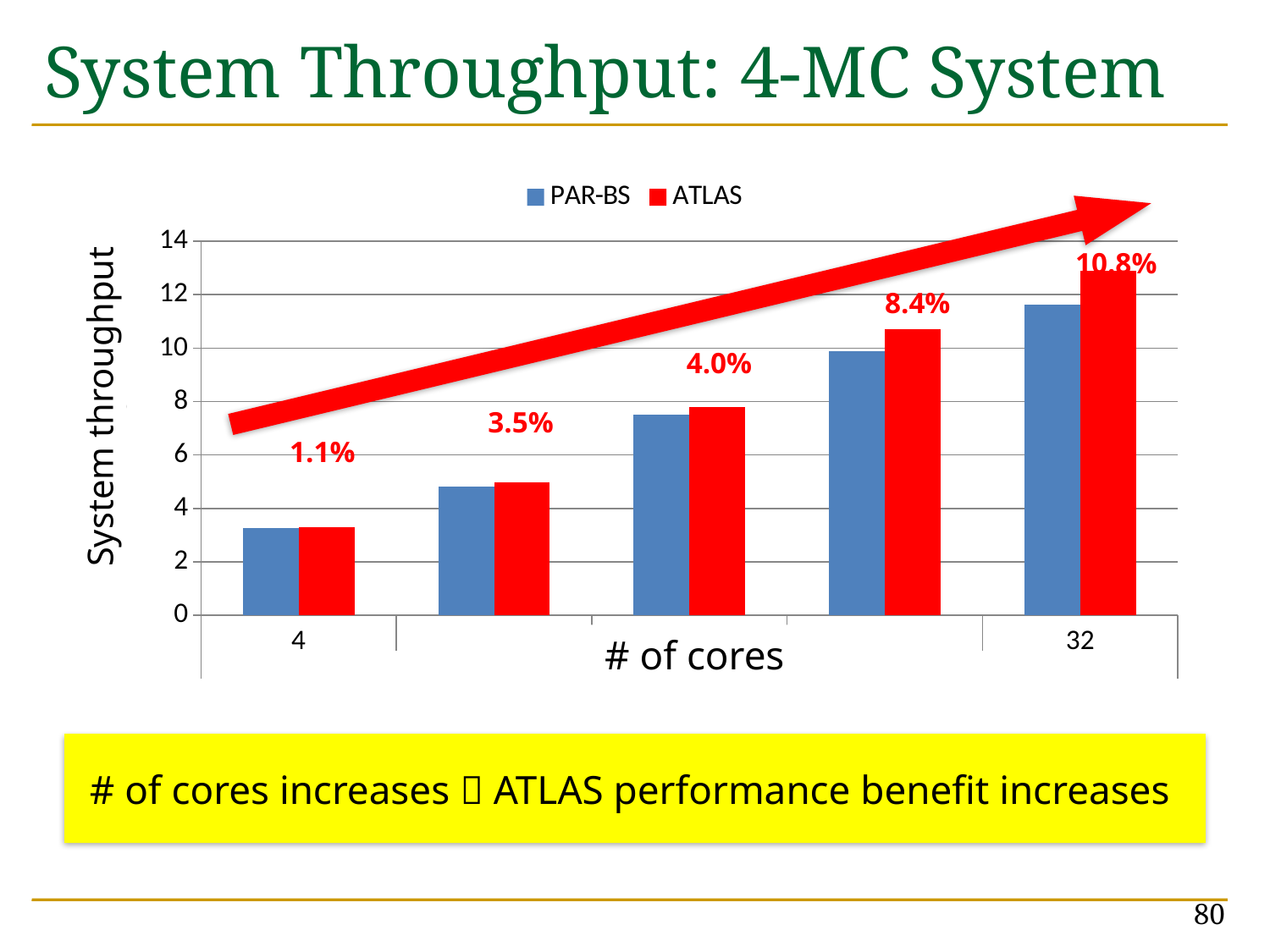
How many groups of bars are plotted along the x axis? 5 How many series does the legend list? 2 What is the label on the y axis? System throughput Is the ATLAS value for 32 cores greater or less than 12? greater What are the two series named in the legend? PAR-BS and ATLAS Is the PAR-BS value for 4 cores greater or less than 4? less Which group of bars has the highest percentage label? 32 What percentage label is shown above the bars for 4 cores? 1.1% What percentage label is shown above the bars for 32 cores? 10.8% Do the system throughput values rise or fall as the number of cores increases along the x axis? rise Which group of bars has the lowest percentage label? 4 What kind of chart is shown on the slide? bar chart